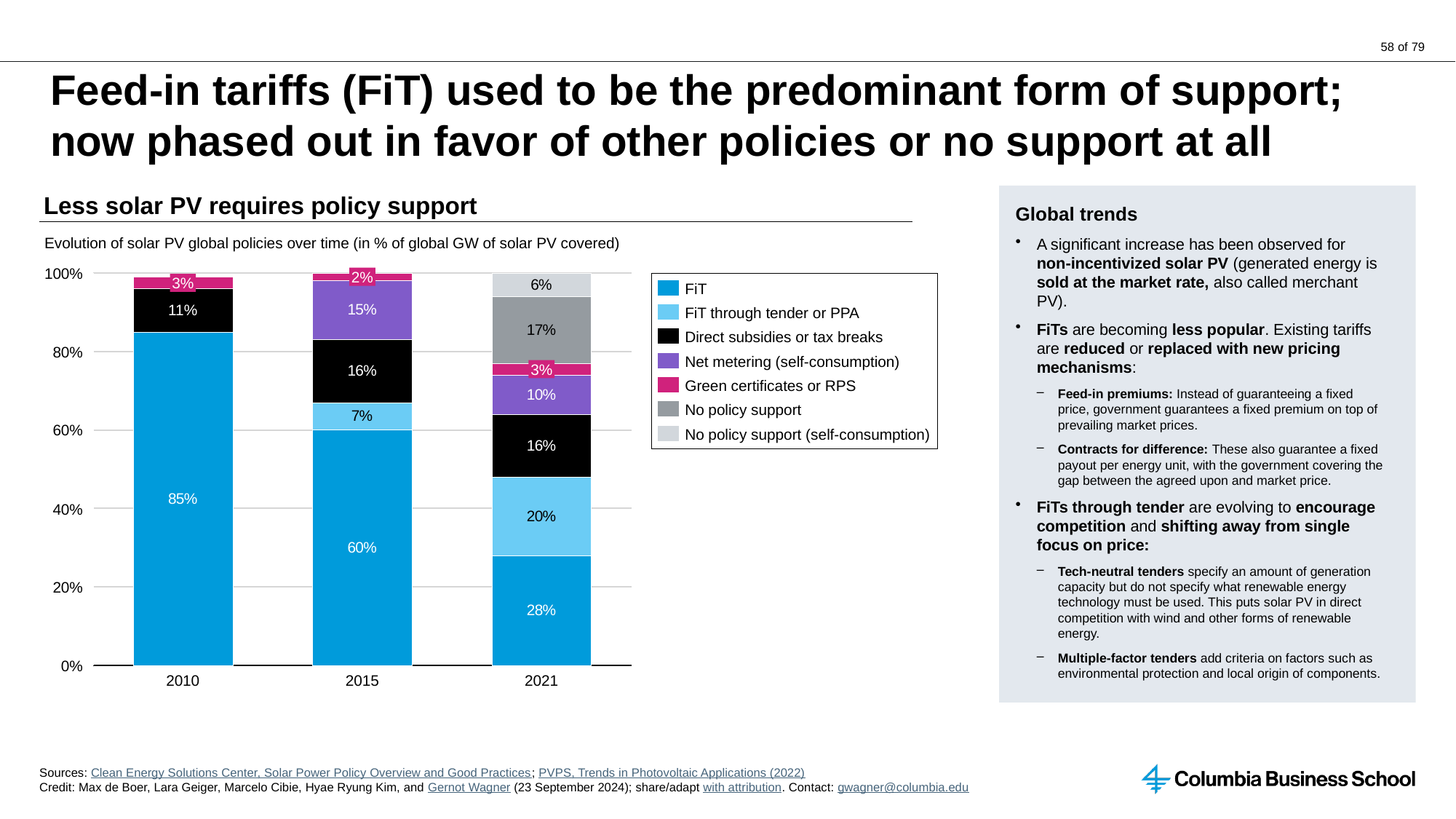
How does the FiT share change from 2010 to 2021? It falls What is the value for FiT through tender or PPA in 2021? 20% What kind of chart is shown on the slide? Stacked bar chart What is the value for Net metering (self-consumption) in 2015? 15% How many years are shown on the x axis? 3 In which year is the FiT share the lowest? 2021 What is the difference between the FiT share in 2010 and in 2015? 25 percentage points What share of global solar PV GW was covered by FiT in 2010? 85% What is the value for No policy support in 2021? 17% Which is larger in 2021: the share for Direct subsidies or tax breaks or the share for Net metering (self-consumption)? Direct subsidies or tax breaks Which legend entry is shown in black? Direct subsidies or tax breaks How many series does the legend list? 7